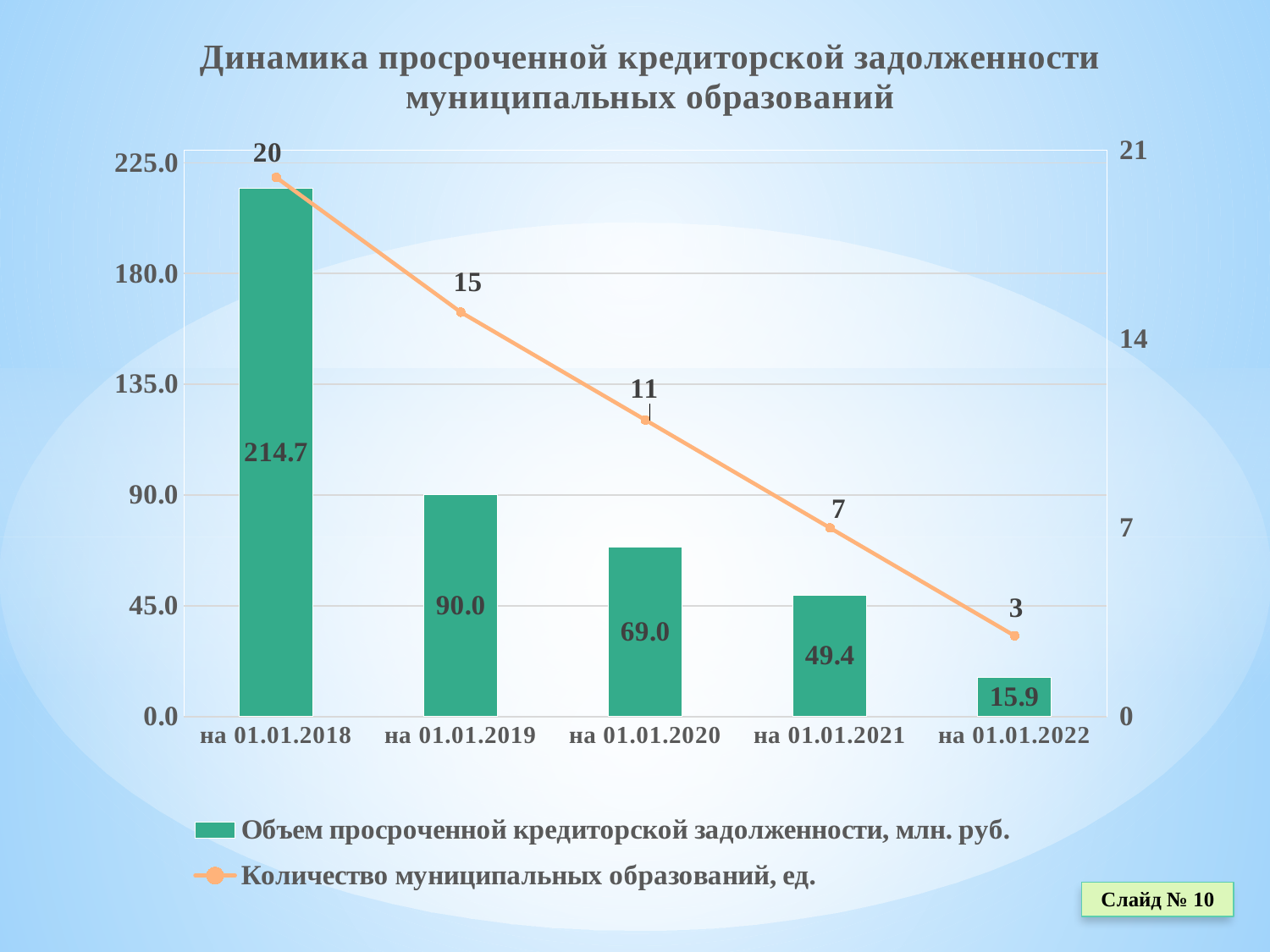
What is the difference in the volume of overdue accounts payable between 01.01.2019 and 01.01.2020? 21.0 What kind of chart is this? Combined bar and line chart What is the volume of overdue accounts payable (млн. руб.) on 01.01.2022? 15.9 By how much did the number of municipalities decrease from 01.01.2018 to 01.01.2021? 13 On which date is the number of municipalities the lowest? на 01.01.2022 What is the number of municipalities (ед.) on 01.01.2020? 11 Does the number of municipalities rise or fall from 01.01.2018 to 01.01.2022? Fall How many dates are shown on the x axis? 5 On which date is the volume of overdue accounts payable the highest? на 01.01.2018 How many series does the legend list? 2 What is the volume of overdue accounts payable (млн. руб.) on 01.01.2018? 214.7 Which is larger: the volume of overdue accounts payable on 01.01.2020 or on 01.01.2021? на 01.01.2020